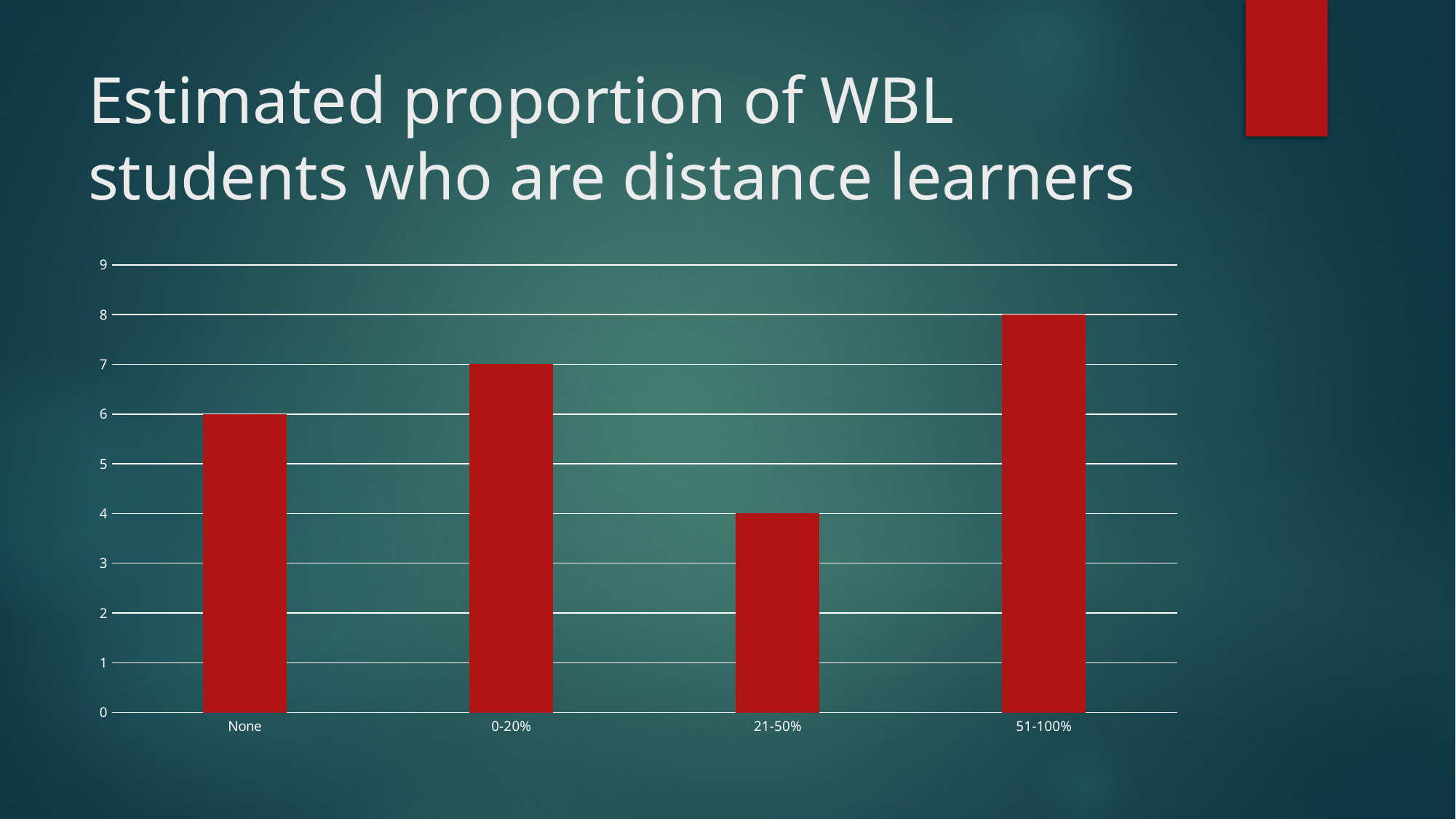
Which is larger, the value for "None" or the value for "0-20%"? 0-20% What is the value for the "21-50%" category? 4 What kind of chart is shown on the slide? bar chart Which category has the lowest value? 21-50% Is the value for "21-50%" greater or less than 5? less What is the title of the slide containing the chart? Estimated proportion of WBL students who are distance learners What is the difference between the values for "51-100%" and "21-50%"? 4 How many categories are shown on the x axis? 4 Which category has the highest value? 51-100% What is the value for the "0-20%" category? 7 What is the value for the "None" category? 6 What is the value for the "51-100%" category? 8